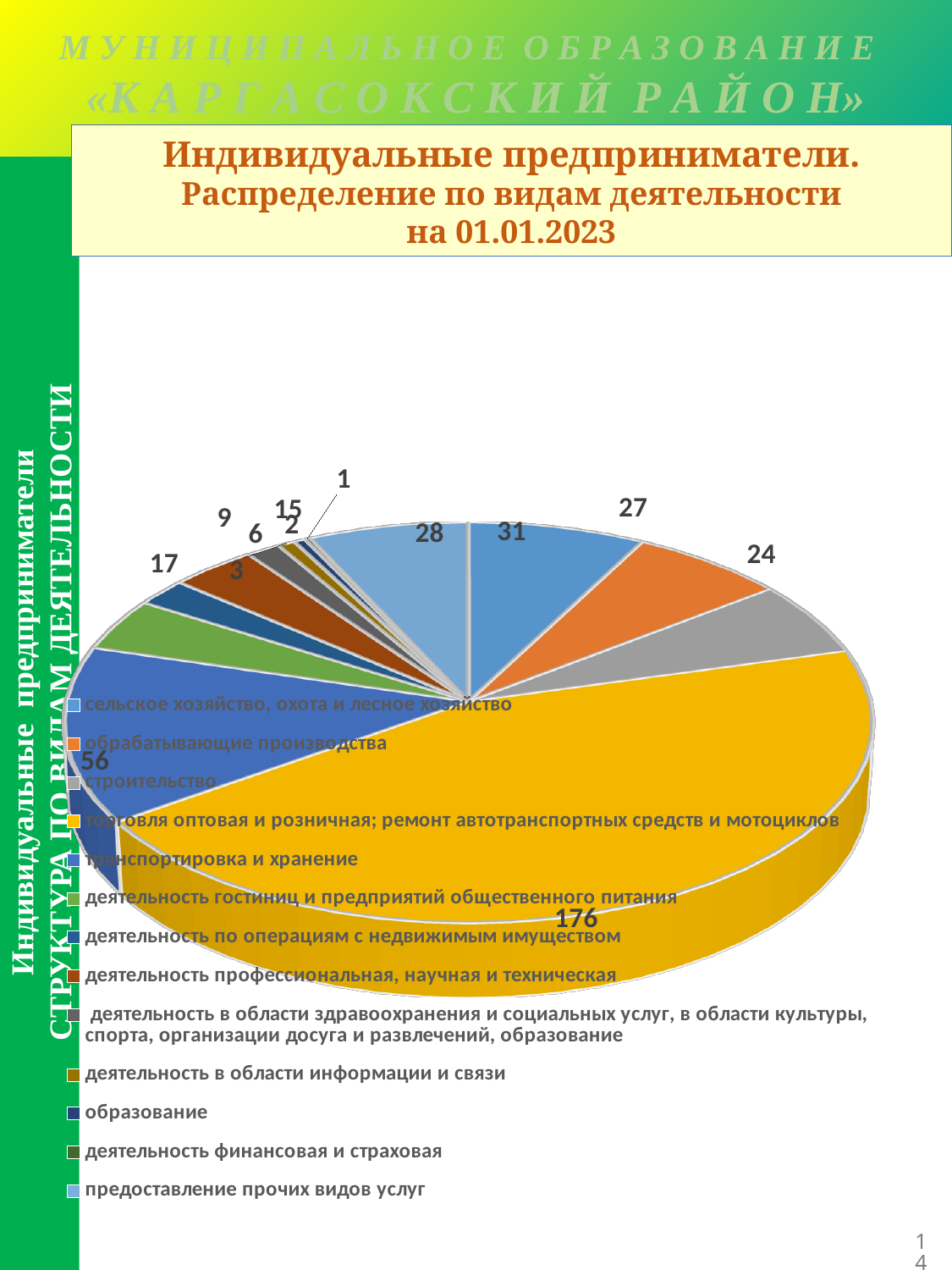
What is the value for сельское хозяйство, охота и лесное хозяйство? 31 What is the smallest data label shown on the pie chart? 1 What is the value for торговля оптовая и розничная; ремонт автотранспортных средств и мотоциклов? 176 What is the value for предоставление прочих видов услуг? 28 How many categories does the legend list? 13 What is the value for транспортировка и хранение? 56 What is the value for строительство? 24 What type of chart is shown on the slide? pie chart Which is larger: the value for сельское хозяйство, охота и лесное хозяйство or the value for предоставление прочих видов услуг? сельское хозяйство, охота и лесное хозяйство What is the value for обрабатывающие производства? 27 Which category has the largest slice in the pie chart? торговля оптовая и розничная; ремонт автотранспортных средств и мотоциклов What is the difference between the values for торговля оптовая и розничная and транспортировка и хранение? 120